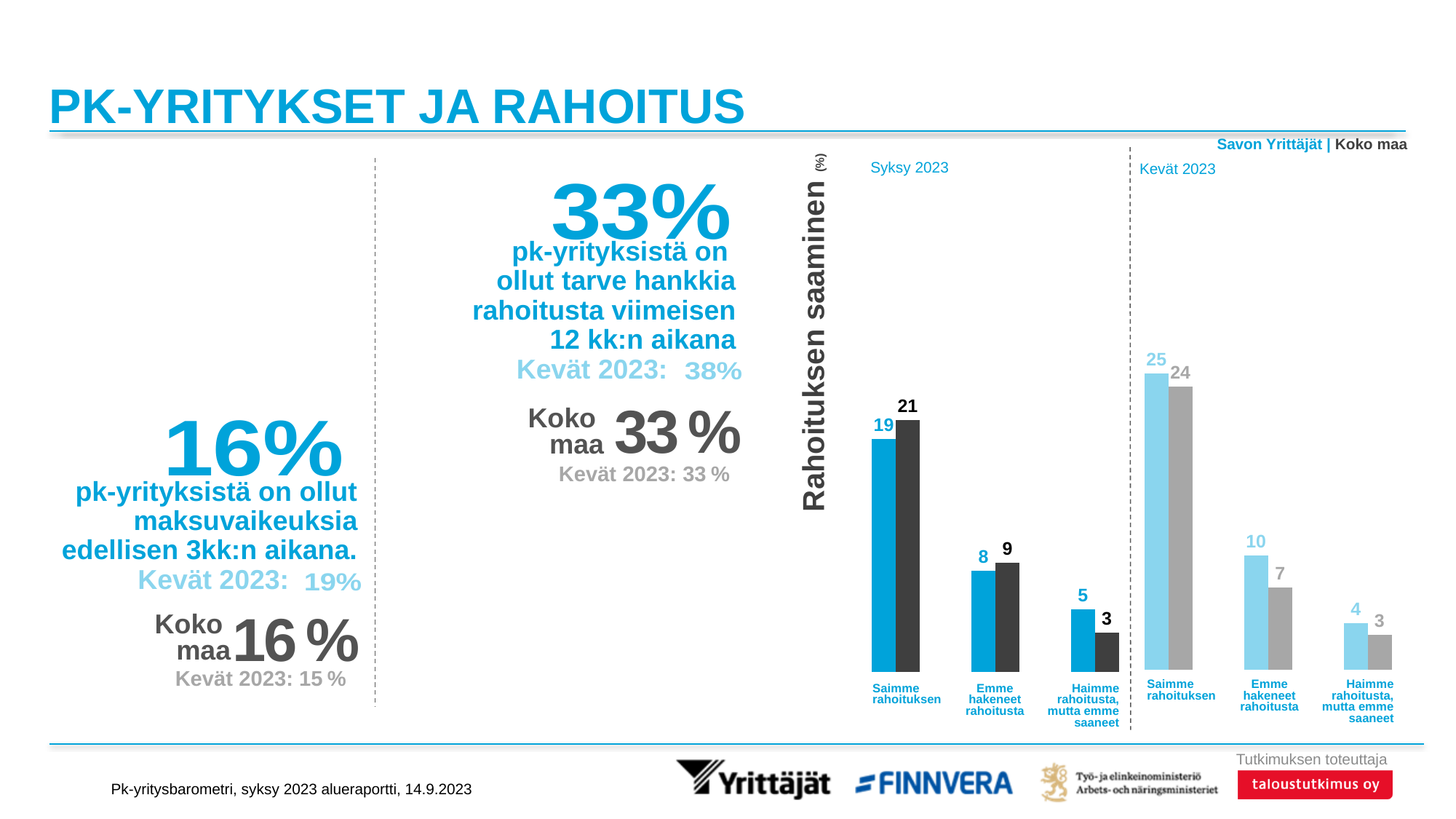
In the Rahoituksen saaminen chart, which category has the lowest Koko maa value in Kevät 2023? Haimme rahoitusta, mutta emme saaneet In the Rahoituksen saaminen chart, what is the Koko maa value for Haimme rahoitusta, mutta emme saaneet in Kevät 2023? 3 What kind of chart is the Rahoituksen saaminen chart? Bar chart In the Rahoituksen saaminen chart, which category has the highest Savon Yrittäjät value in Syksy 2023? Saimme rahoituksen In the Rahoituksen saaminen chart, what is the Savon Yrittäjät value for Emme hakeneet rahoitusta in Kevät 2023? 10 In the Rahoituksen saaminen chart, what is the Savon Yrittäjät value for Saimme rahoituksen in Syksy 2023? 19 In the Rahoituksen saaminen chart, what is the difference between the Savon Yrittäjät and Koko maa values for Emme hakeneet rahoitusta in Kevät 2023? 3 In the Rahoituksen saaminen chart, what is the Koko maa value for Saimme rahoituksen in Syksy 2023? 21 In the Rahoituksen saaminen chart, for Haimme rahoitusta, mutta emme saaneet in Syksy 2023, which is larger: Savon Yrittäjät or Koko maa? Savon Yrittäjät In the Rahoituksen saaminen chart, what is the difference between the Savon Yrittäjät values for Saimme rahoituksen in Kevät 2023 and Syksy 2023? 6 How many categories are shown in each period of the Rahoituksen saaminen chart? 3 Which two periods are compared in the Rahoituksen saaminen chart? Syksy 2023 and Kevät 2023